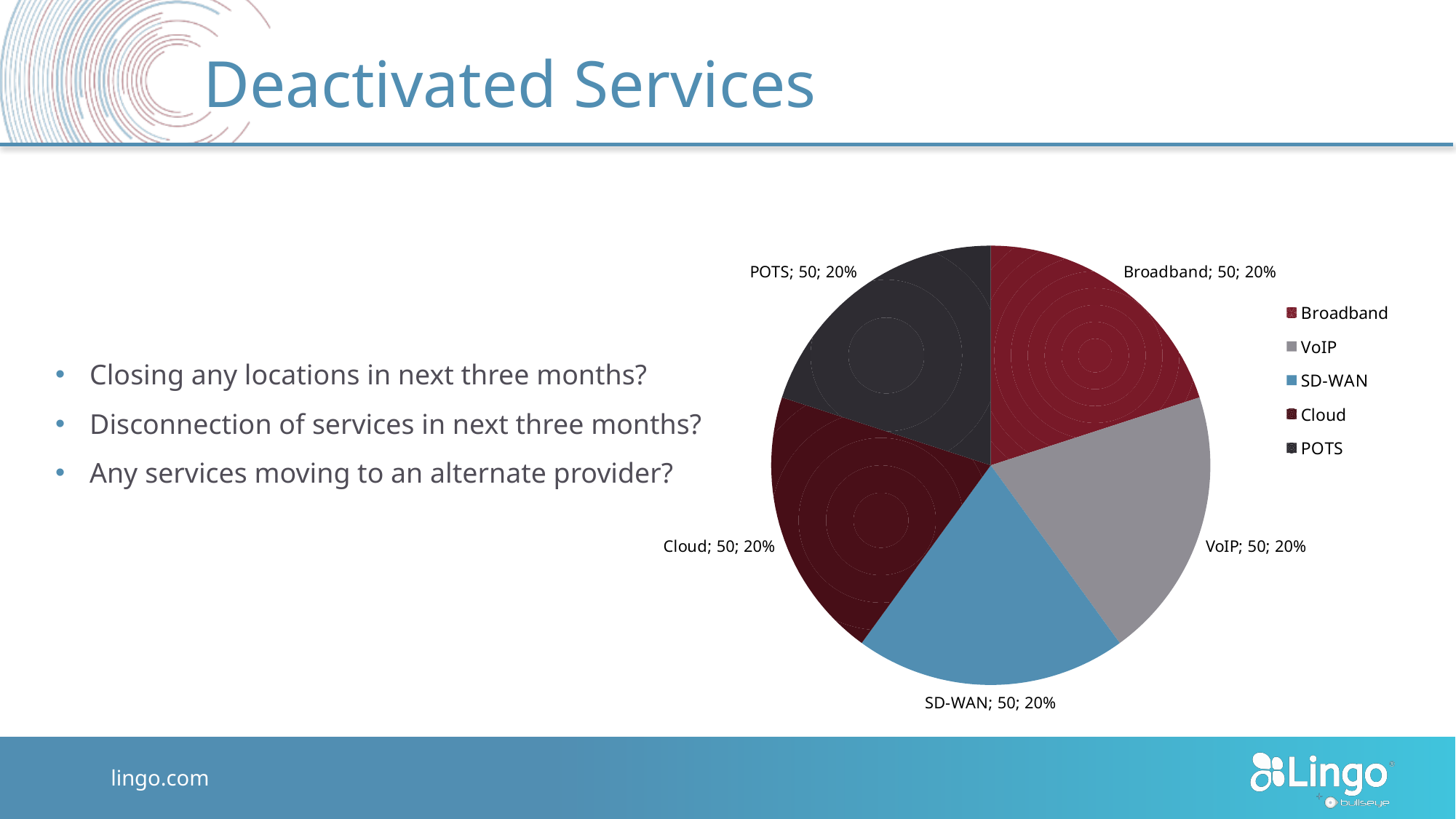
What is the difference between the values for Broadband and VoIP? 0 What is the value for Broadband? 50 How many entries does the legend list? 5 What is the value for POTS? 50 Which legend entry is listed first? Broadband What share of the pie does Cloud represent? 20% How many slices does the pie chart have? 5 What is the value for SD-WAN? 50 What share of the pie does VoIP represent? 20% What kind of chart is shown on the slide? pie chart What is the total of all slice values in the pie chart? 250 What colour is the SD-WAN slice? blue